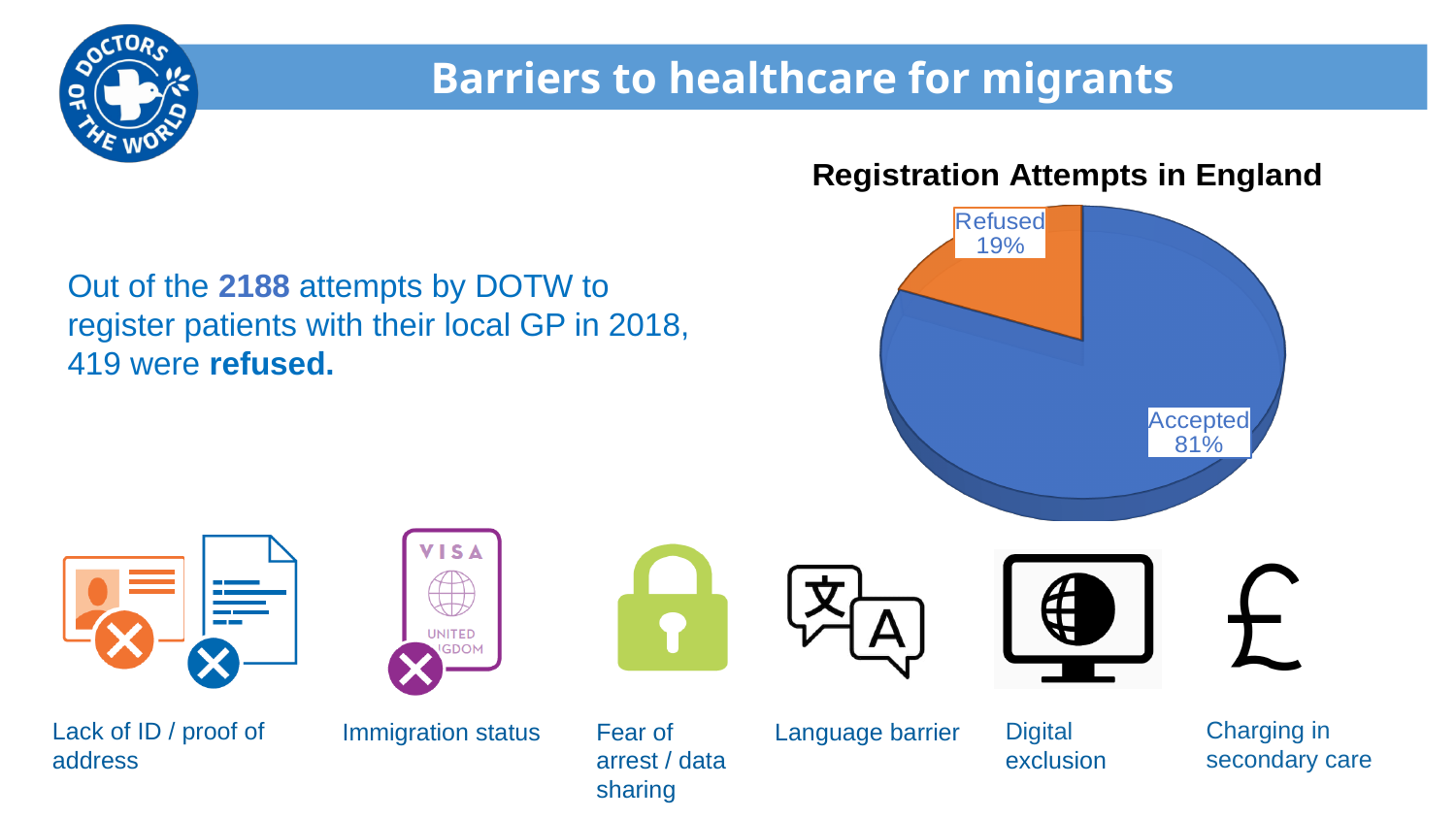
What share of registration attempts were Accepted? 81% What kind of chart is shown under the title "Registration Attempts in England"? pie chart What is the difference in percentage points between the Accepted and Refused slices? 62 percentage points How many slices does the pie chart have? 2 Which slice of the pie chart is the largest? Accepted What colour is the Refused slice of the pie chart? orange What share of registration attempts were Refused? 19% Which slice of the pie chart is the smallest? Refused Is the share for Refused greater or less than 25%? less Which is larger in the pie chart, Accepted or Refused? Accepted What is the title of the chart on the slide? Registration Attempts in England